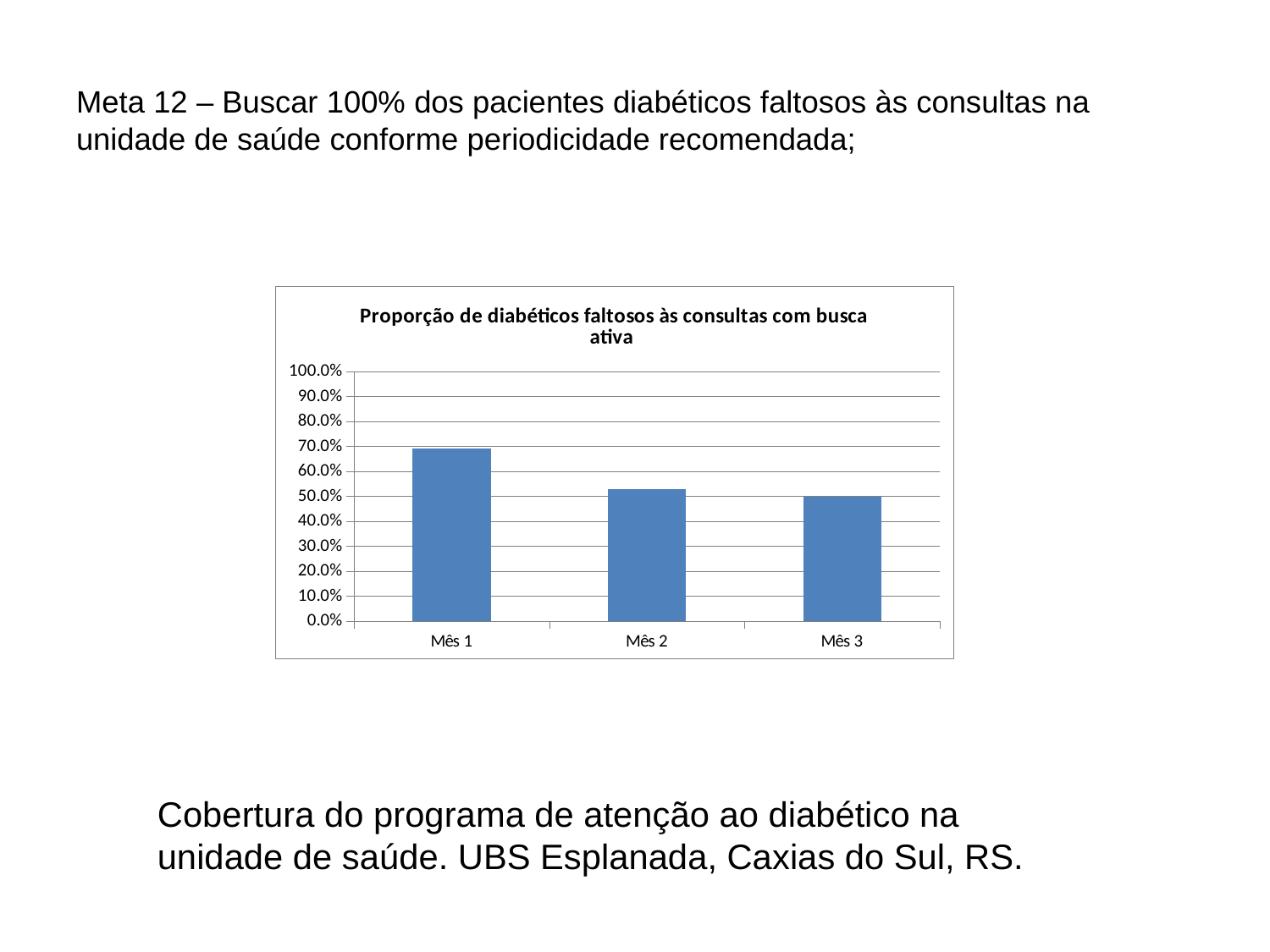
Is the value for Mês 3 greater or less than 60%? less How many categories (months) are plotted on the chart? 3 Which is larger, the value for Mês 1 or the value for Mês 3? Mês 1 Is the value for Mês 2 greater or less than 60%? less Is the value for Mês 1 greater or less than 60%? greater What is the title of the chart? Proporção de diabéticos faltosos às consultas com busca ativa Do the values rise or fall from Mês 1 to Mês 3? fall What kind of chart is shown on the slide? bar chart Which is larger, the value for Mês 1 or the value for Mês 2? Mês 1 Which month has the highest proportion of diabetics with active search? Mês 1